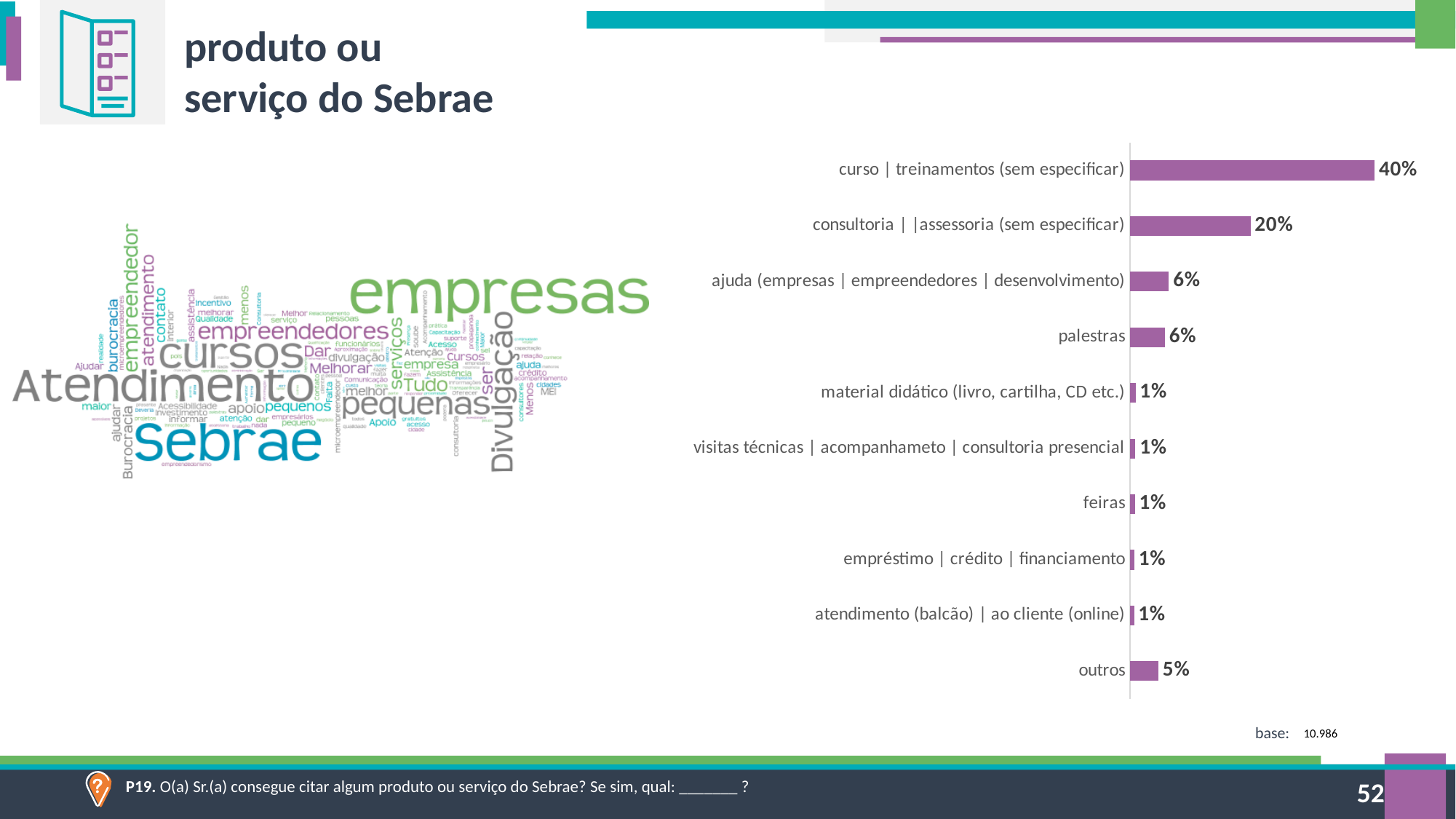
What is the value for "outros"? 5% What base (number of respondents) is shown below the chart? 10.986 What is the value for "palestras"? 6% What is the difference between the values for "curso | treinamentos (sem especificar)" and "consultoria | |assessoria (sem especificar)"? 20% What is the difference between the values for "ajuda (empresas | empreendedores | desenvolvimento)" and "outros"? 1% What is the value for "feiras"? 1% What is the value for "consultoria | |assessoria (sem especificar)"? 20% Which is larger, the value for "outros" or the value for "feiras"? outros What kind of chart is shown on the right of the slide? bar chart What is the value for "curso | treinamentos (sem especificar)"? 40% Which category has the highest value? curso | treinamentos (sem especificar) How many categories are shown in the bar chart? 10